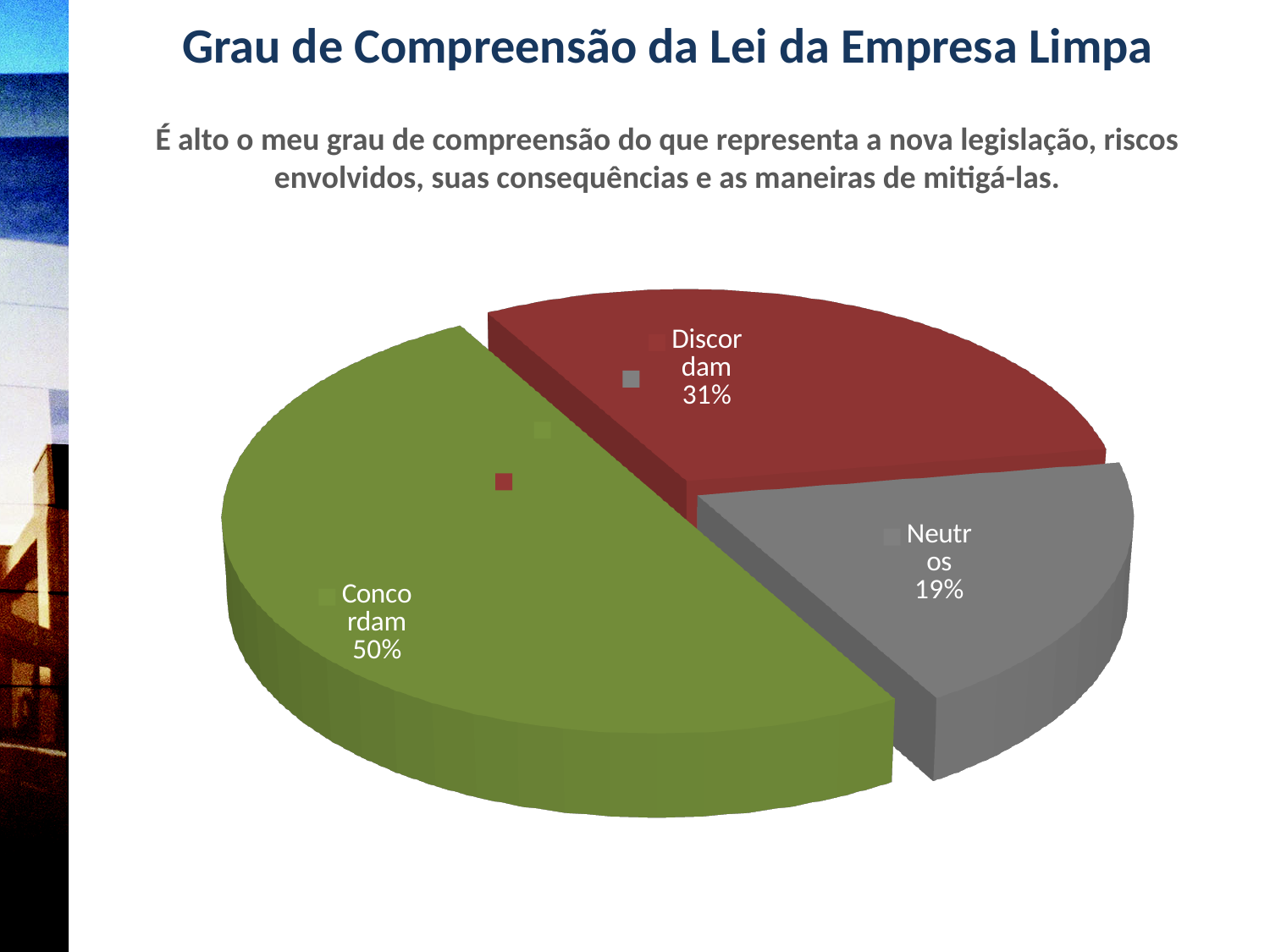
What percentage of respondents are in the Neutros slice? 19% What is the difference in percentage points between the Concordam and Discordam slices? 19 Which slice of the pie is the largest? Concordam Which slice of the pie is the smallest? Neutros What colour is the Concordam slice? green What kind of chart is shown on the slide? pie chart What is the title of the slide containing the pie chart? Grau de Compreensão da Lei da Empresa Limpa What is the difference in percentage points between the Discordam and Neutros slices? 12 Which is larger, the Discordam slice or the Neutros slice? Discordam How many slices does the pie chart have? 3 What percentage of respondents are in the Discordam slice? 31% What percentage of respondents are in the Concordam slice? 50%